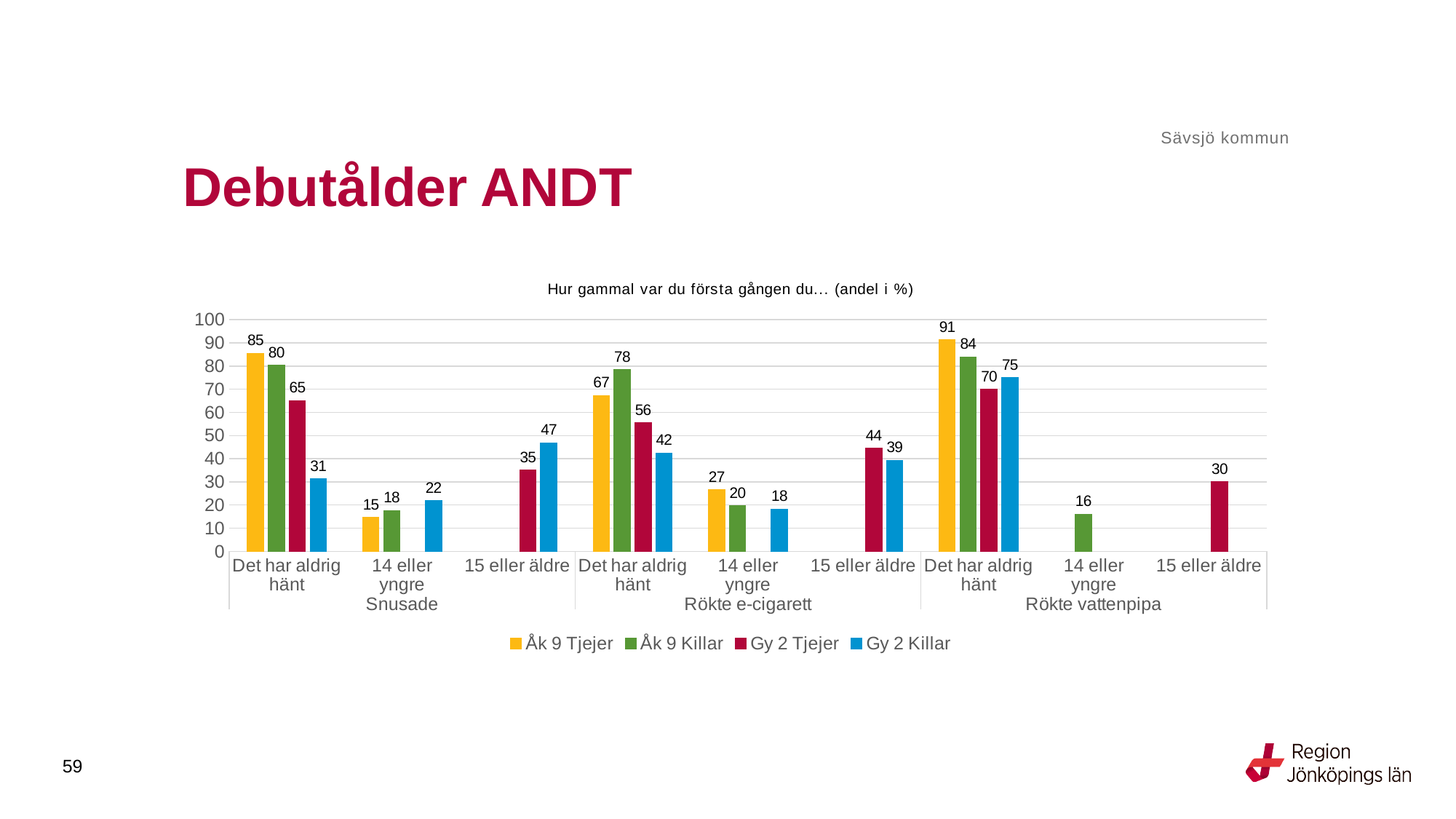
What is the value for Åk 9 Tjejer for 'Det har aldrig hänt' under Snusade? 85 What kind of chart is shown on the slide? bar chart Is the value for Gy 2 Killar for '15 eller äldre' under Snusade greater or less than 40? greater What is the value for Gy 2 Killar for '15 eller äldre' under Rökte e-cigarett? 39 Which series has the lowest value for 'Det har aldrig hänt' under Snusade? Gy 2 Killar What is the value for Åk 9 Killar for '14 eller yngre' under Rökte vattenpipa? 16 What is the value for Gy 2 Tjejer for '15 eller äldre' under Rökte vattenpipa? 30 How many series does the legend list? 4 What is the difference between Åk 9 Killar and Gy 2 Tjejer for 'Det har aldrig hänt' under Rökte e-cigarett? 22 Which is larger for '14 eller yngre' under Snusade: Åk 9 Killar or Gy 2 Killar? Gy 2 Killar What is the title of the chart? Hur gammal var du första gången du… (andel i %) Which series has the highest value for 'Det har aldrig hänt' under Rökte vattenpipa? Åk 9 Tjejer